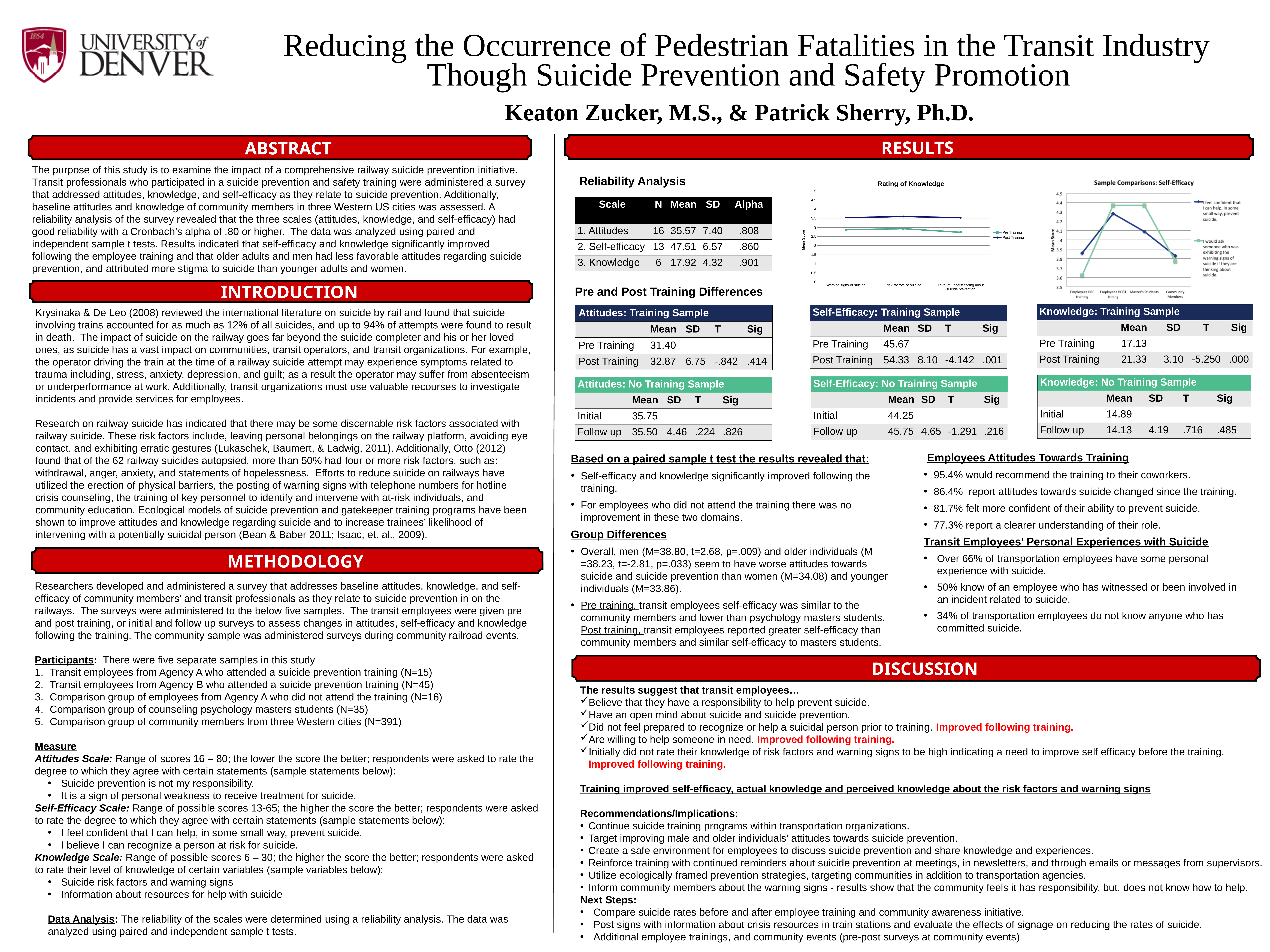
In the "Sample Comparisons: Self-Efficacy" chart, is the value for Employees PRE training in the "I feel confident that I can help, in some small way, prevent suicide" series greater or less than 4? less In the "Rating of Knowledge" chart, which series has the higher value for Risk factors of suicide, Pre Training or Post Training? Post Training How many categories are shown on the x axis of the "Rating of Knowledge" chart? 3 What kind of chart is the "Rating of Knowledge" chart? line chart In the "Sample Comparisons: Self-Efficacy" chart, at which category is the "I would ask someone who was exhibiting the warning signs of suicide if they are thinking about suicide" series lowest? Employees PRE training In the "Sample Comparisons: Self-Efficacy" chart, at which category is the "I feel confident that I can help, in some small way, prevent suicide" series highest? Employees POST trining How many series does the legend of the "Rating of Knowledge" chart list? 2 How many categories are shown on the x axis of the "Sample Comparisons: Self-Efficacy" chart? 4 What is the y-axis label of the "Rating of Knowledge" chart? Mean Score How many series does the legend of the "Sample Comparisons: Self-Efficacy" chart list? 2 In the "Rating of Knowledge" chart, is the Post Training value for Warning signs of suicide greater or less than 3? greater In the "Rating of Knowledge" chart, is the Pre Training value for Level of understanding about suicide prevention greater or less than 3? less